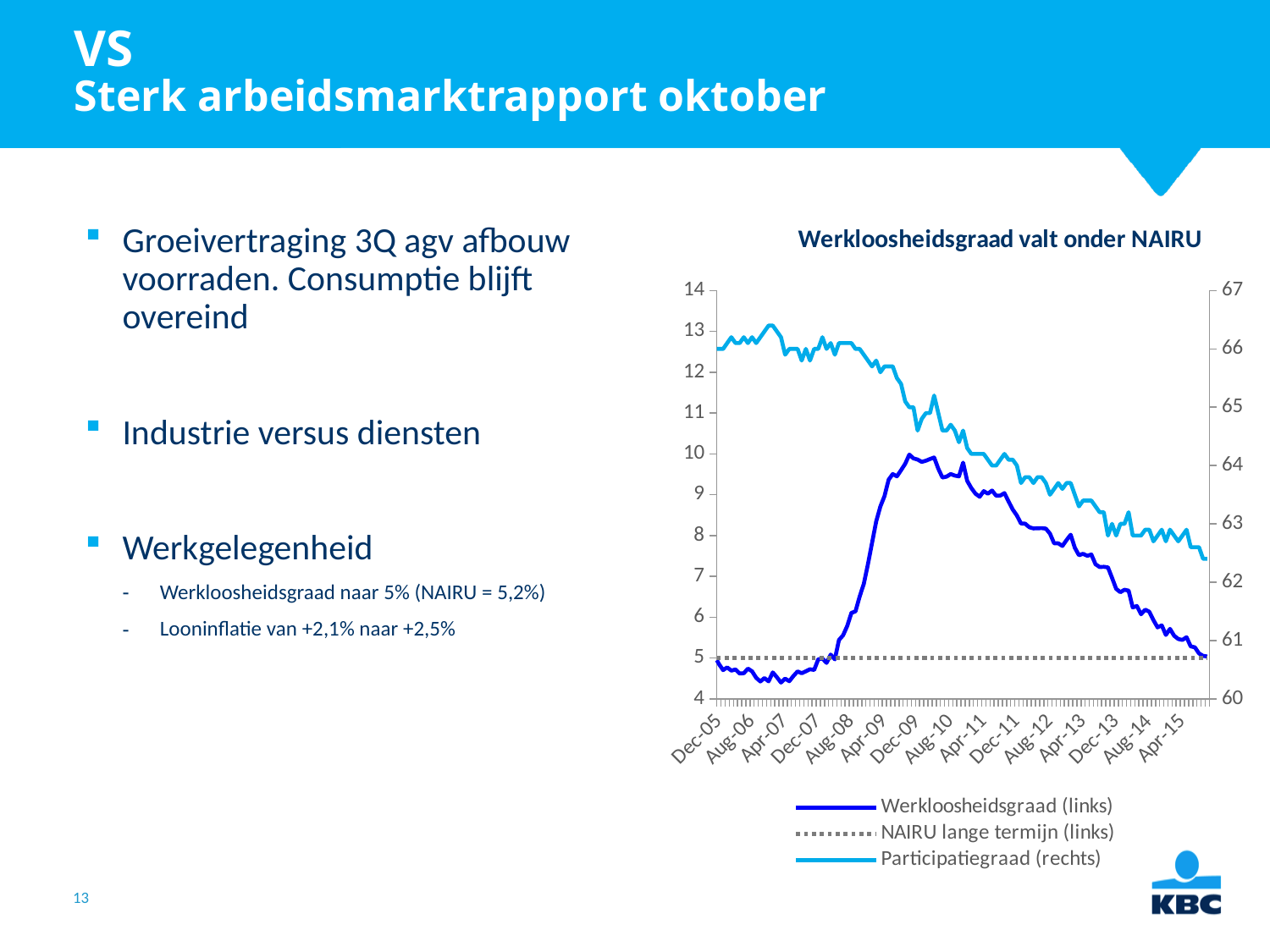
What is the title of the chart? Werkloosheidsgraad valt onder NAIRU Is the Werkloosheidsgraad value at Dec-07 greater or less than 6? less Is the Participatiegraad value at Dec-05 greater or less than 65? greater Is the Werkloosheidsgraad value at Dec-09 greater or less than 9? greater Does the Werkloosheidsgraad series rise or fall between Dec-09 and Apr-15? fall What kind of chart is shown on the slide? line chart In which year does the Werkloosheidsgraad series reach its highest point? 2009 Does the Participatiegraad series rise or fall over the period from Dec-05 to Apr-15? fall How many series does the chart legend list? 3 Which series in the chart is plotted against the right-hand axis? Participatiegraad (rechts)